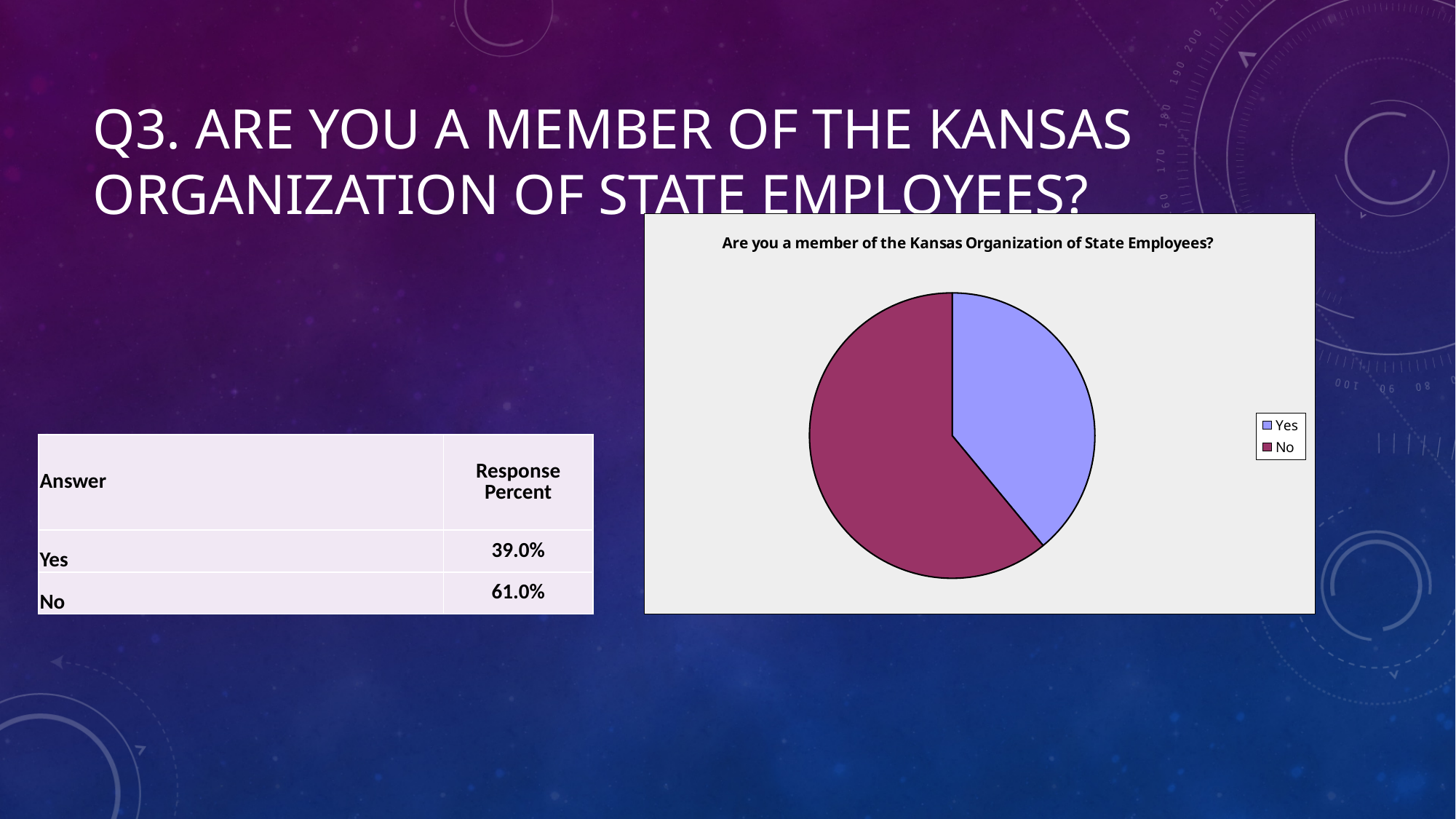
What share of the pie does the No slice represent? 61.0% What is the title of the chart? Are you a member of the Kansas Organization of State Employees? Which response has the largest slice of the pie? No How many slices does the pie chart have? 2 What share of the pie does the Yes slice represent? 39.0% Which slice is larger, Yes or No? No What colour is the No slice in the pie chart? dark red Is the share for Yes greater or less than 50%? less What is the difference in percentage points between the No and Yes responses? 22.0% Which response has the smallest slice of the pie? Yes What kind of chart is shown on the slide? pie chart How many entries does the legend list? 2